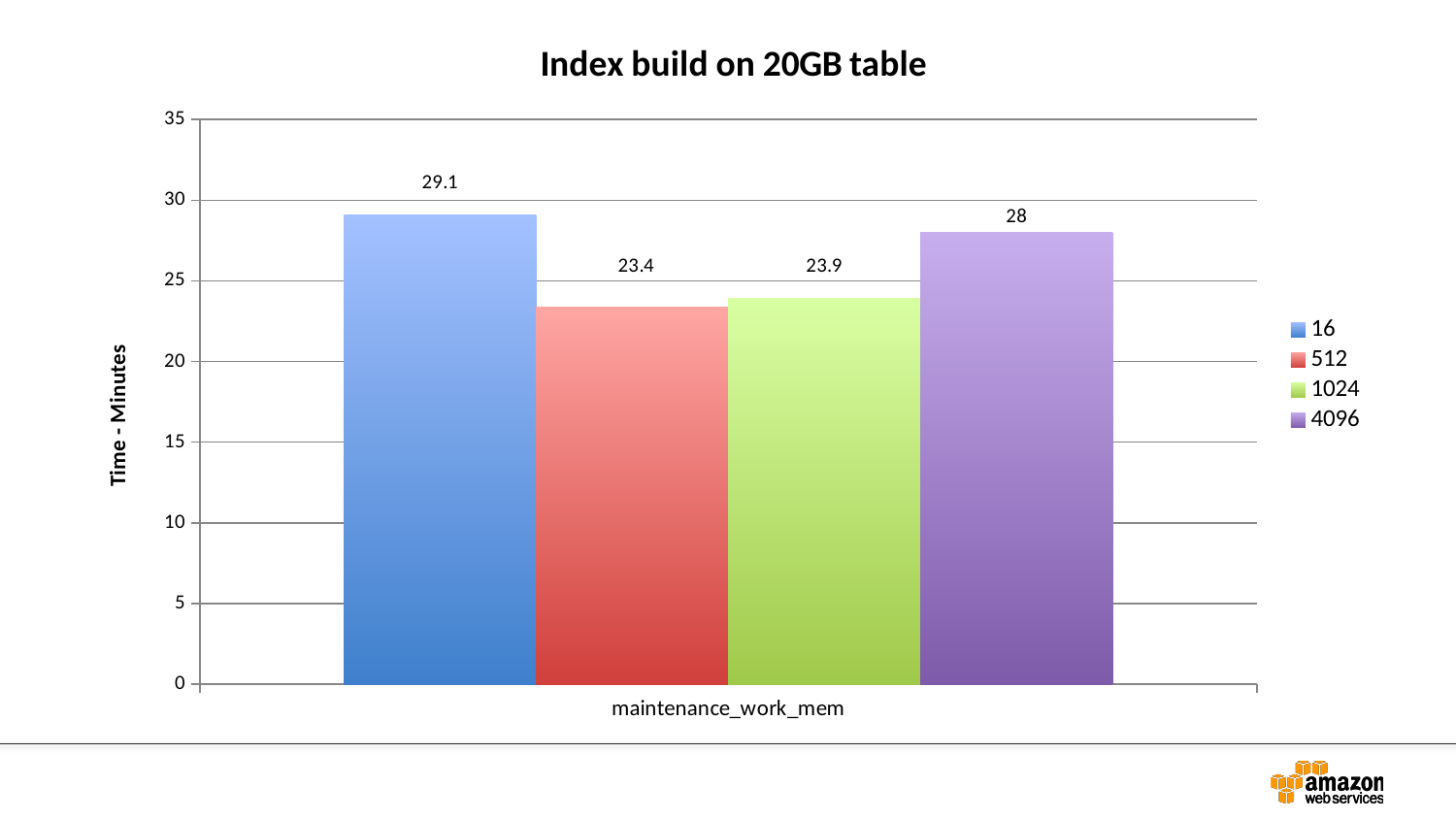
What is the difference in build time between the 16 and 512 settings? 5.7 What is the label of the vertical axis? Time - Minutes What is the title of the chart? Index build on 20GB table Which has a longer build time, the 4096 setting or the 1024 setting? 4096 What is the index build time for maintenance_work_mem of 512? 23.4 What kind of chart is shown on the slide? bar chart How many series does the legend list? 4 What is the index build time for maintenance_work_mem of 1024? 23.9 Which maintenance_work_mem setting has the lowest index build time? 512 What is the index build time for maintenance_work_mem of 16? 29.1 Which maintenance_work_mem setting has the highest index build time? 16 What is the index build time for maintenance_work_mem of 4096? 28